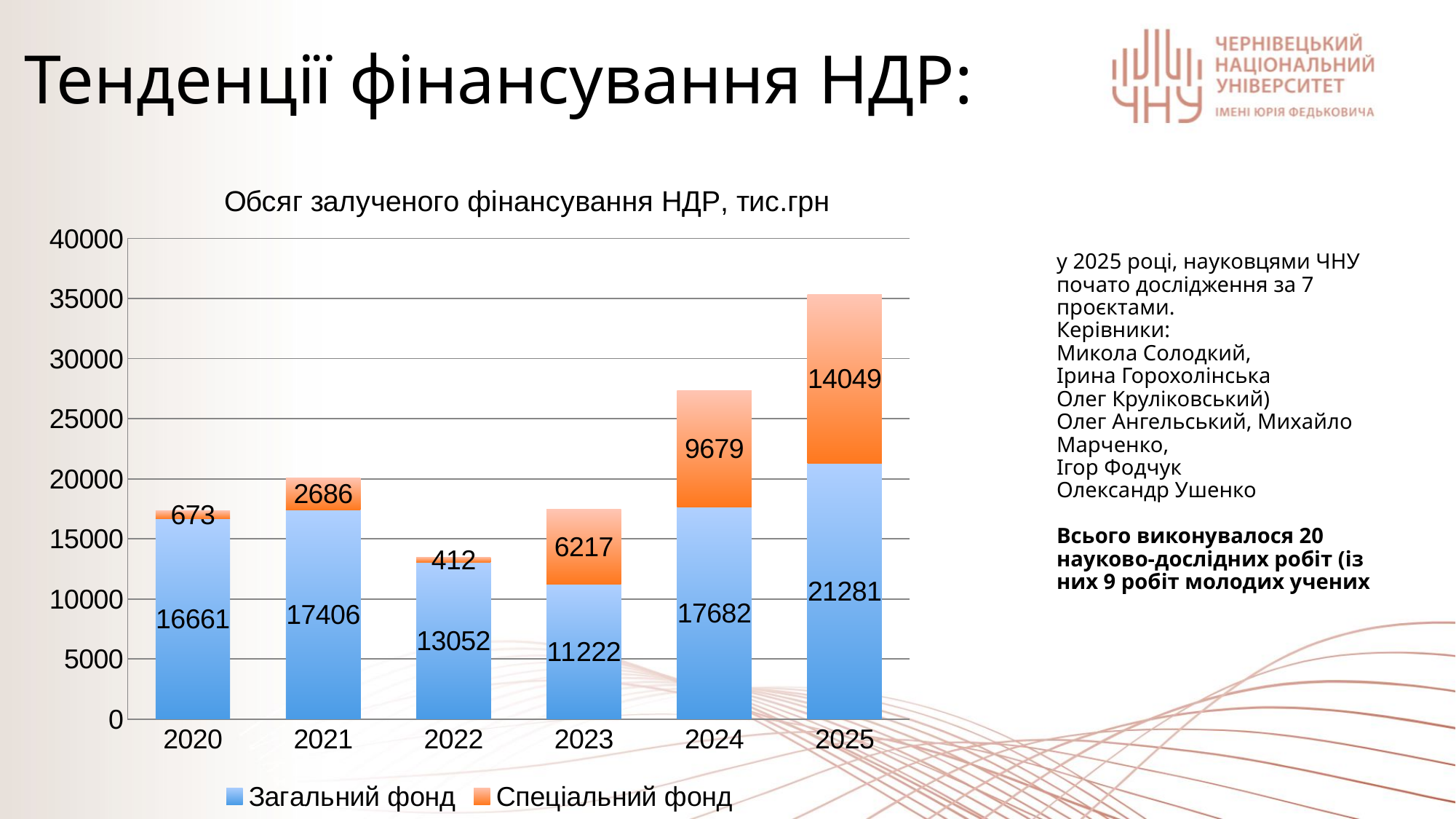
What is the total of the stacked bar for 2024? 27361 What is the total of the stacked bar for 2025? 35330 How many series does the legend list? 2 What is the value of Спеціальний фонд for 2023? 6217 What is the difference between the Загальний фонд values for 2025 and 2024? 3599 How many years are shown on the x axis? 6 What type of chart is shown on the slide? Stacked bar chart Which is larger: Загальний фонд in 2021 or in 2022? 2021 Which year has the highest value for Загальний фонд? 2025 What is the value of Спеціальний фонд for 2020? 673 Which year has the lowest value for Спеціальний фонд? 2022 What is the value of Загальний фонд for 2025? 21281